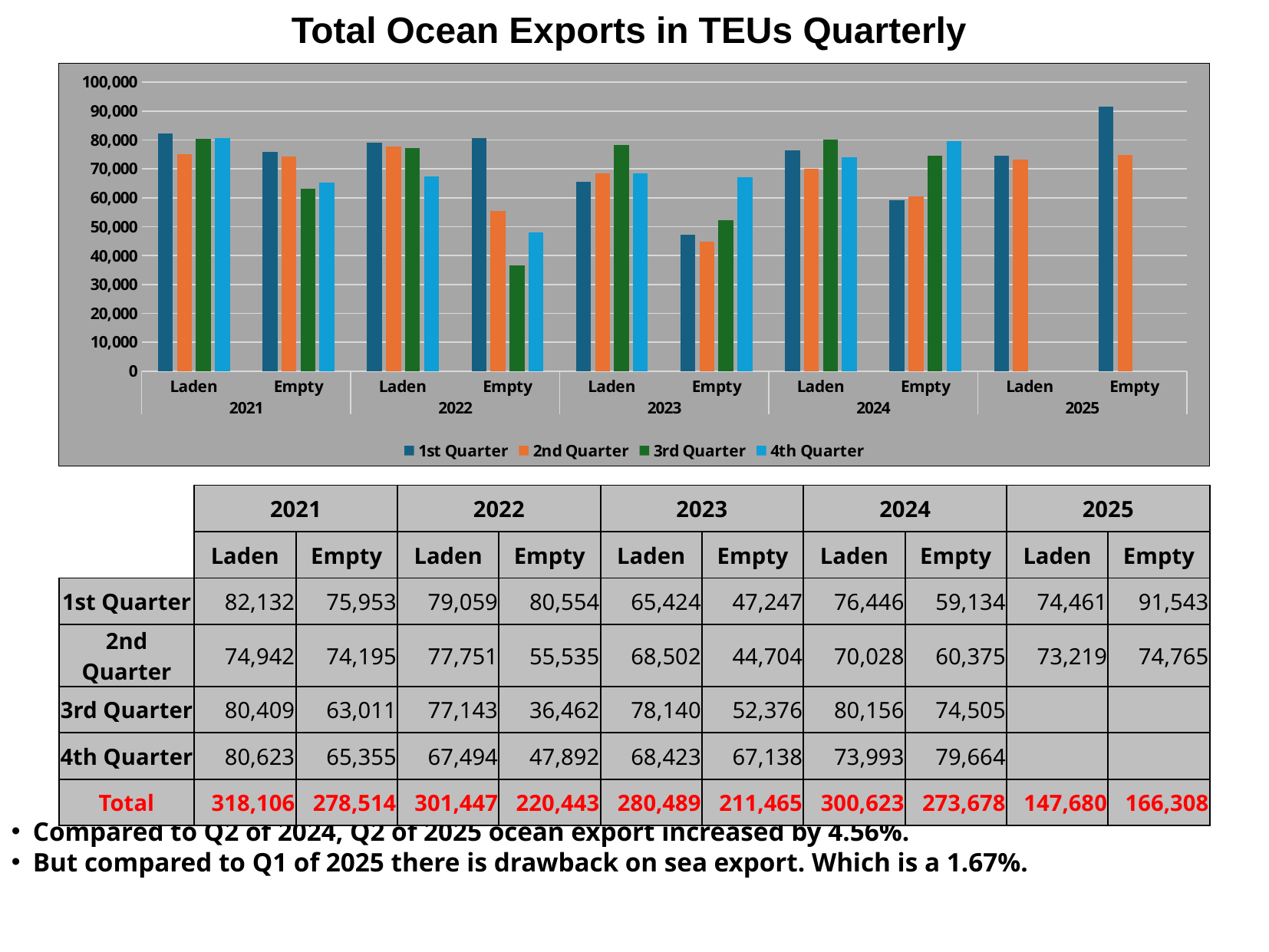
Which bar in the chart is the highest overall? 1st Quarter, Empty, 2025 What kind of chart is shown on the slide? bar chart How many years are shown along the x axis of the chart? 5 What is the 1st Quarter value for Empty in 2025? 91,543 In 2023, which is larger for the 3rd Quarter: Laden or Empty? Laden What is the 4th Quarter value for Empty in 2024? 79,664 Which bar in the chart is the lowest overall? 3rd Quarter, Empty, 2022 What is the title of the chart? Total Ocean Exports in TEUs Quarterly Is the 2nd Quarter value for Empty in 2022 greater or less than 60,000? less Do the Empty values for 2024 rise or fall from the 1st Quarter to the 4th Quarter? rise What is the difference between the 1st Quarter and 2nd Quarter values for Laden in 2021? 7,190 How many series does the chart legend list? 4